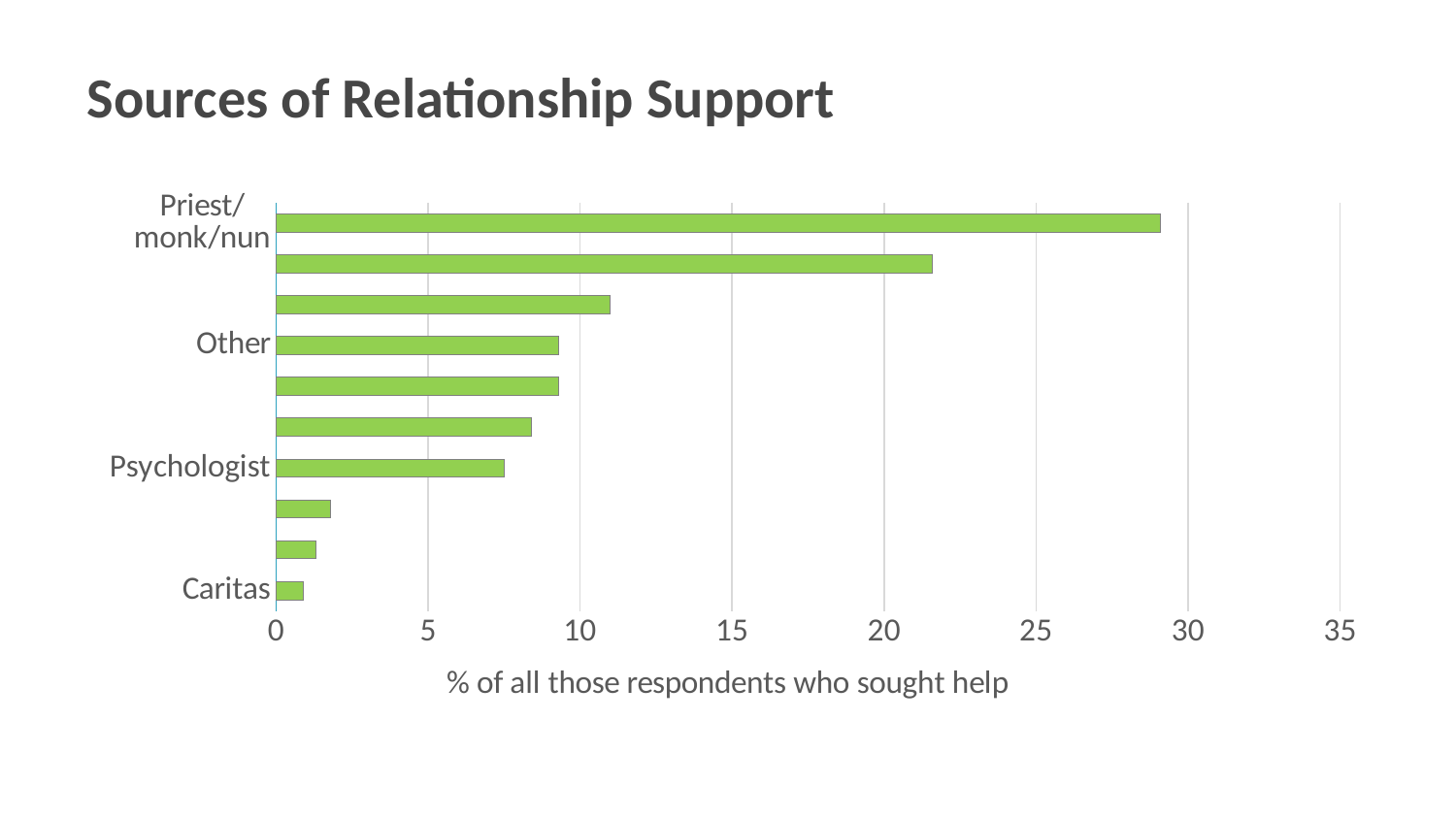
Which labelled category has the highest value? Priest/monk/nun What is the title of the chart? Sources of Relationship Support How many bars are plotted in the chart? 10 Which is larger, the value for Priest/monk/nun or the value for Caritas? Priest/monk/nun Is the value for Caritas greater or less than 5? less Is the value for Psychologist greater or less than 5? greater Is the value for Other greater or less than 10? less Which labelled category has the lowest value? Caritas What kind of chart is shown on the slide? bar chart What is the label on the horizontal axis? % of all those respondents who sought help Which is larger, the value for Other or the value for Psychologist? Other